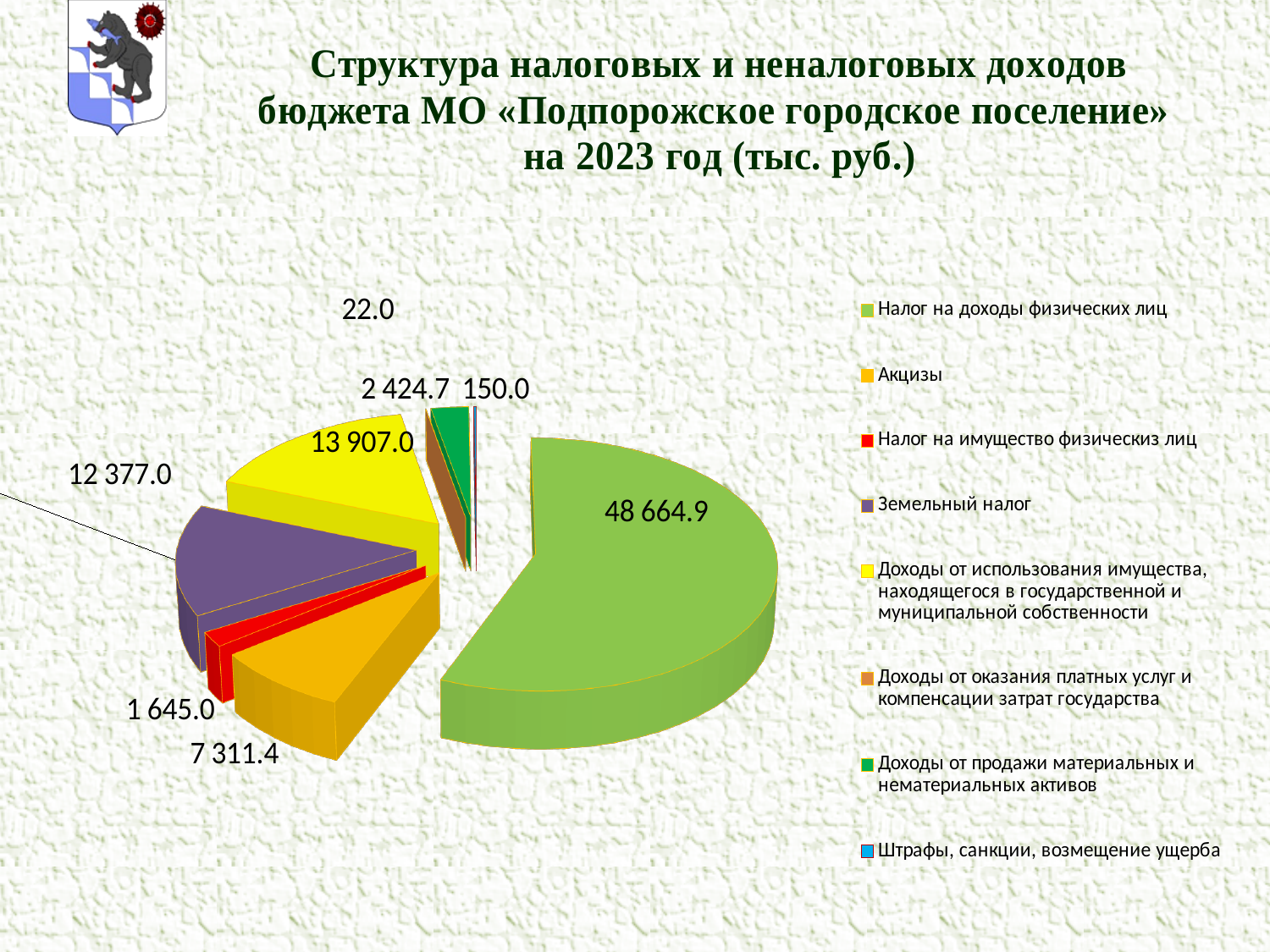
What is the difference between the values for «Доходы от использования имущества...» (13 907.0) and «Земельный налог» (12 377.0)? 1 530.0 What is the value for «Земельный налог»? 12 377.0 How many categories does the legend of the pie chart list? 8 What colour is the slice for «Земельный налог»? Purple What is the value for «Налог на имущество физическиз лиц»? 1 645.0 Which category has the largest slice of the pie? Налог на доходы физических лиц What type of chart is shown on the slide? Pie chart What is the value for «Акцизы»? 7 311.4 Which category has the smallest value in the pie chart? Доходы от оказания платных услуг и компенсации затрат государства Which is larger: the value for «Акцизы» or the value for «Налог на имущество физическиз лиц»? Акцизы What is the value for «Доходы от использования имущества, находящегося в государственной и муниципальной собственности»? 13 907.0 What is the value for «Налог на доходы физических лиц»? 48 664.9